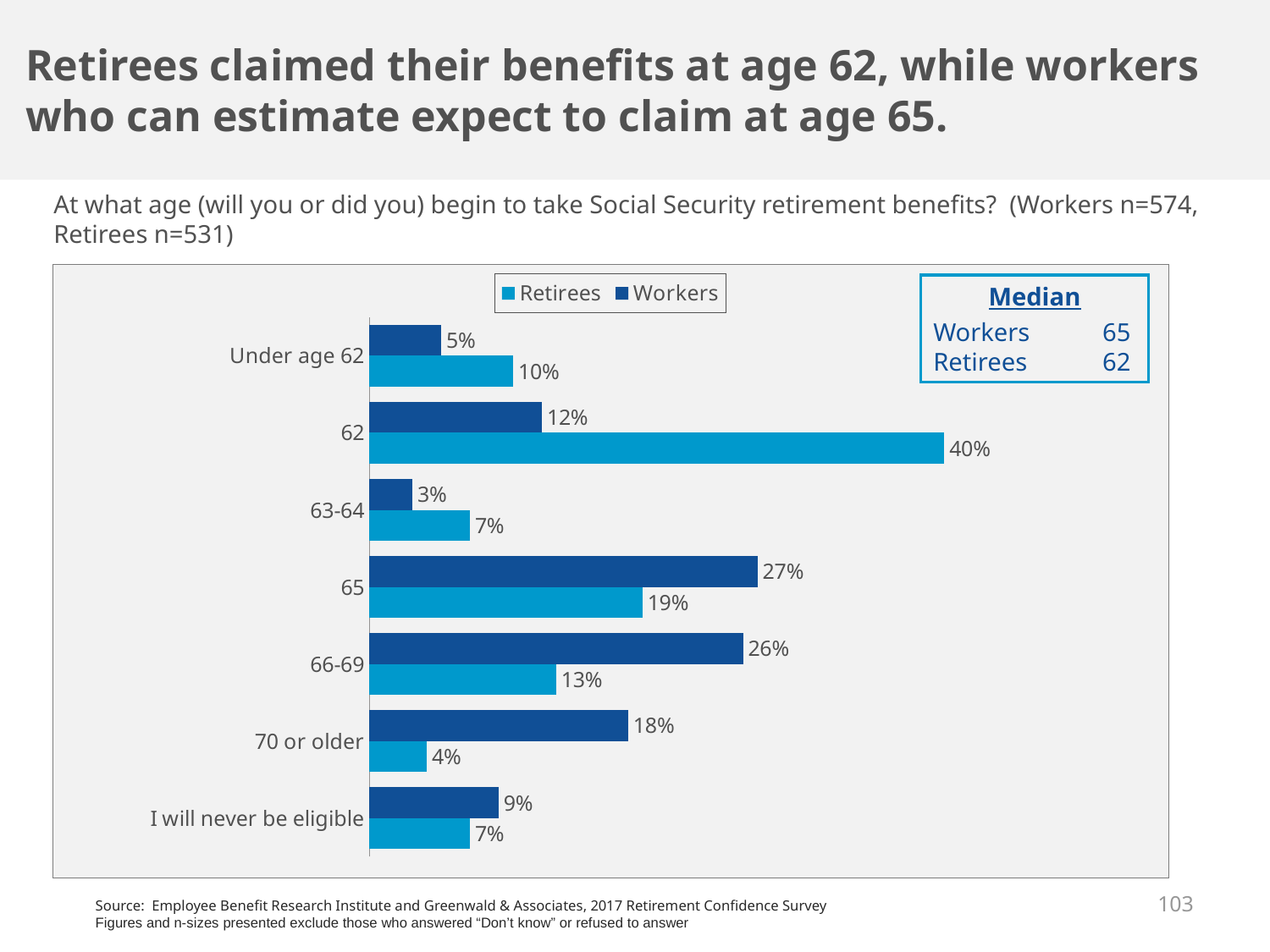
What is the difference between the Retirees and Workers values for age 62? 28% For the 70 or older category, which series has the larger value, Workers or Retirees? Workers What percentage of Retirees began taking benefits at ages 66-69? 13% Which age category has the highest value for Retirees? 62 Which age category has the lowest value for Workers? 63-64 How many age categories are shown on the chart? 7 What percentage of Workers expect to begin taking benefits at age 65? 27% According to the Median box on the chart, what is the median claiming age for Workers? 65 What percentage of Workers expect to claim at age 70 or older? 18% What type of chart is shown on the slide? Bar chart What percentage of Retirees began taking Social Security benefits at age 62? 40% How many series does the legend list? 2